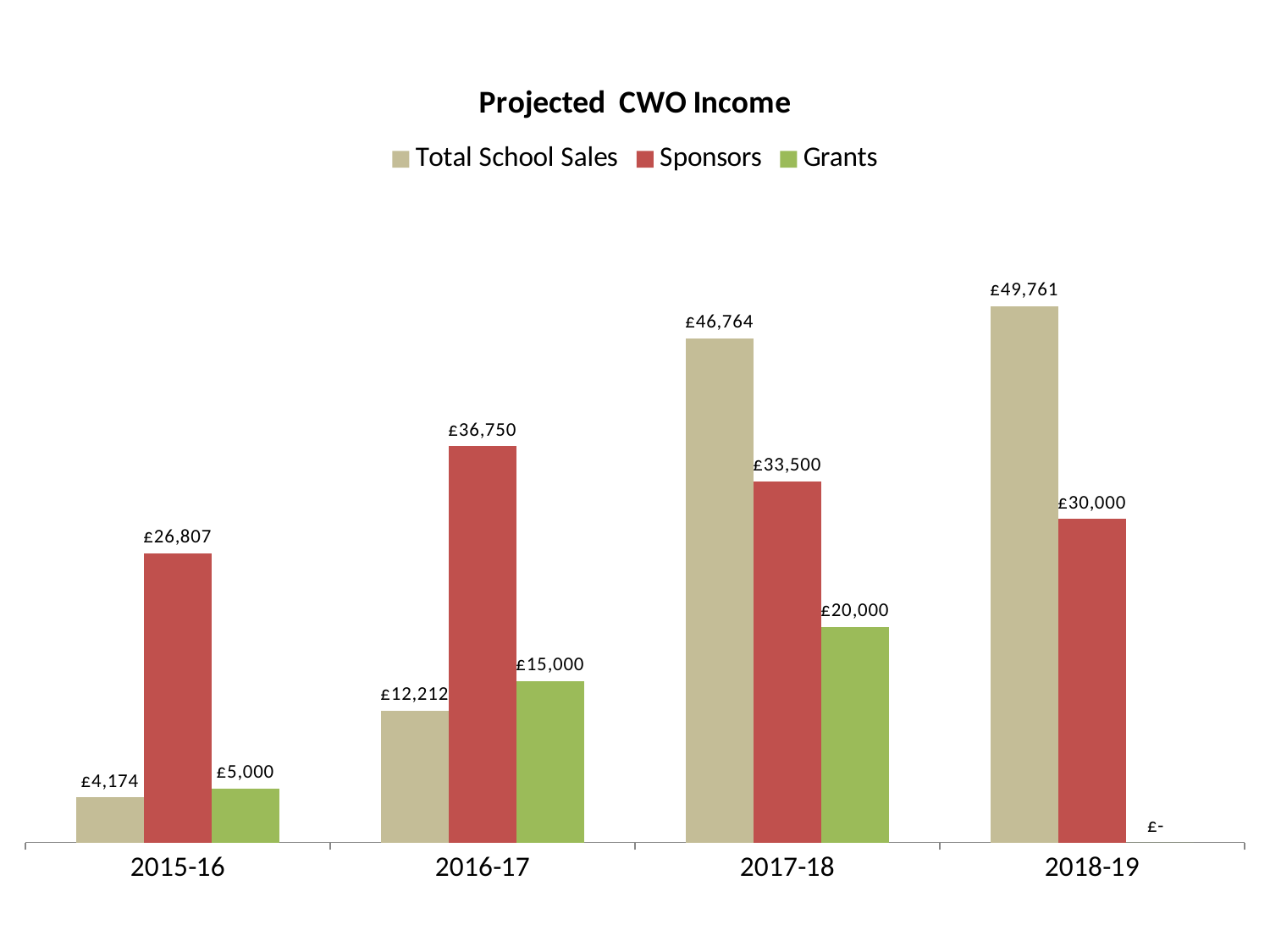
What is the title of the chart? Projected CWO Income Do the Total School Sales values rise or fall from 2015-16 to 2018-19? Rise How many series does the legend list? 3 What is the Grants value for 2015-16? £5,000 Which is larger in 2016-17, Total School Sales or Grants? Grants What kind of chart is this? Bar chart What is the difference between Total School Sales and Sponsors in 2018-19? £19,761 What is the Total School Sales value for 2017-18? £46,764 How many years are shown on the x axis? 4 Which year has the lowest Sponsors value? 2015-16 Which year has the highest Total School Sales? 2018-19 What is the Sponsors value for 2016-17? £36,750